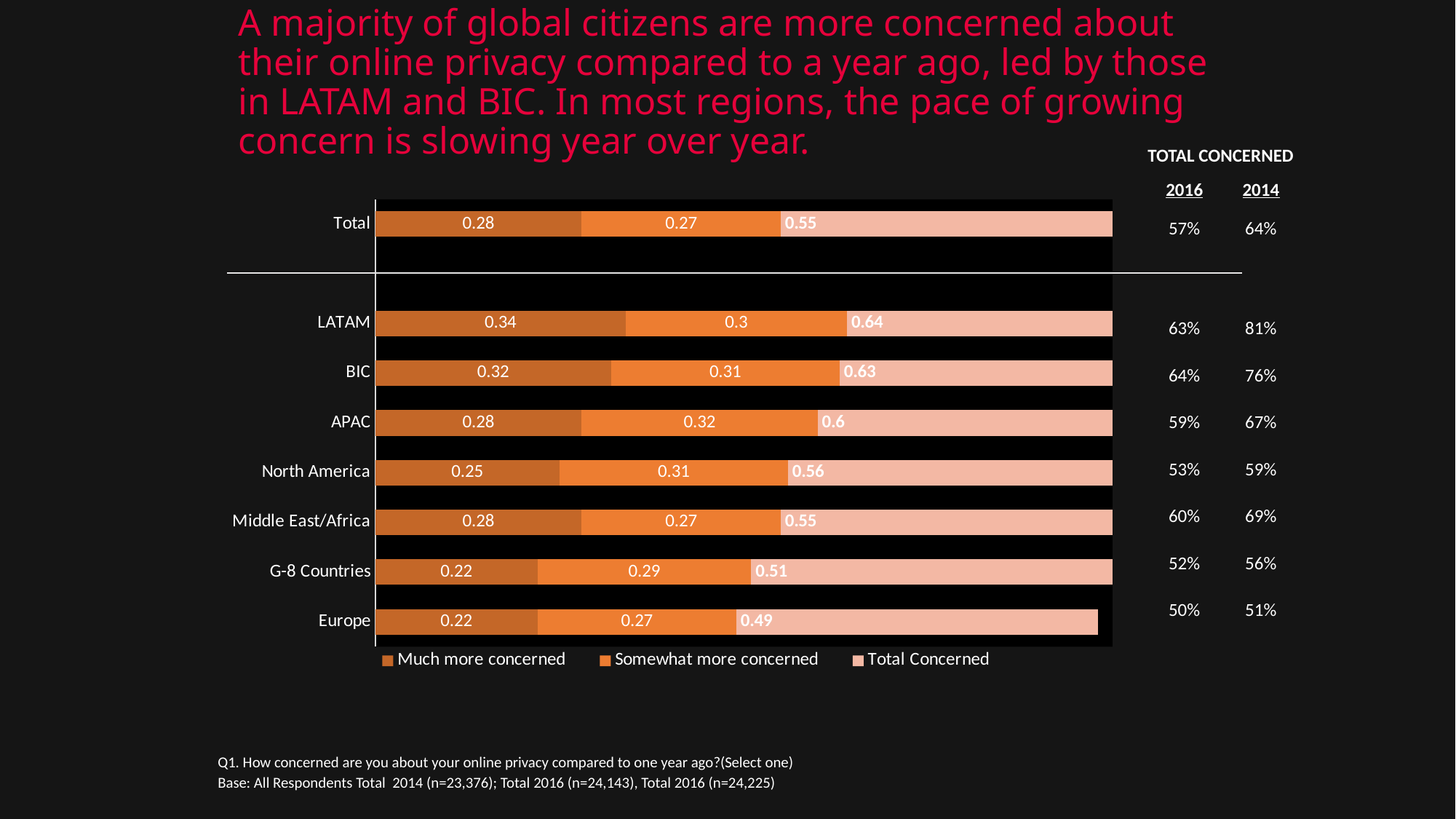
Which has a larger 'Much more concerned' value, LATAM or G-8 Countries? LATAM What is the 'Somewhat more concerned' value for APAC? 0.32 What is the difference between the 'Total Concerned' values for LATAM and Europe? 0.15 What is the 'Much more concerned' value for LATAM? 0.34 How many series does the legend list? 3 How many categories (rows) are shown in the chart? 8 What is the 'Total Concerned' value for Europe? 0.49 What kind of chart is shown on the slide? Stacked bar chart Which region has the lowest 'Total Concerned' value? Europe Which region has the highest 'Total Concerned' value? LATAM What is the difference between the 'Much more concerned' values for BIC and North America? 0.07 Which region has the highest 'Much more concerned' value? LATAM